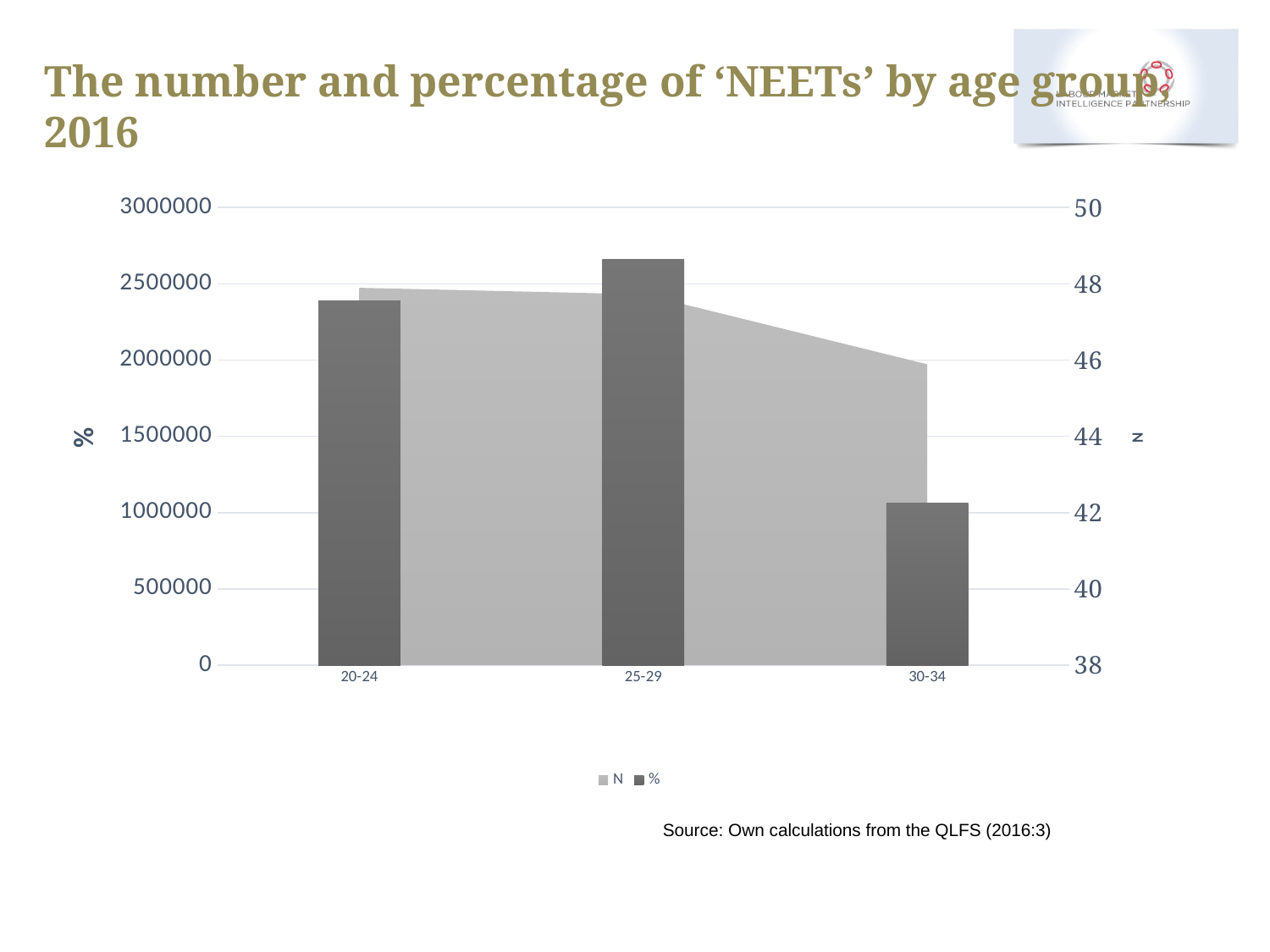
How many series does the chart legend list? 2 Reading against the right-hand axis, is the % bar for 25-29 greater or less than 48? greater Which age group has the tallest % bar? 25-29 What are the two series named in the chart legend? N and % Is the % bar for 20-24 taller or shorter than the % bar for 30-34? taller Which age group has the shortest % bar? 30-34 Does the N series rise or fall from the 25-29 age group to the 30-34 age group? fall What kind of chart is used to plot the % series? bar chart Reading against the left-hand axis, is the N value for 30-34 greater or less than 1500000? greater How many age groups are shown on the x axis of the chart? 3 Reading against the right-hand axis, is the % bar for 30-34 greater or less than 44? less What is the title of the chart on this slide? The number and percentage of 'NEETs' by age group, 2016